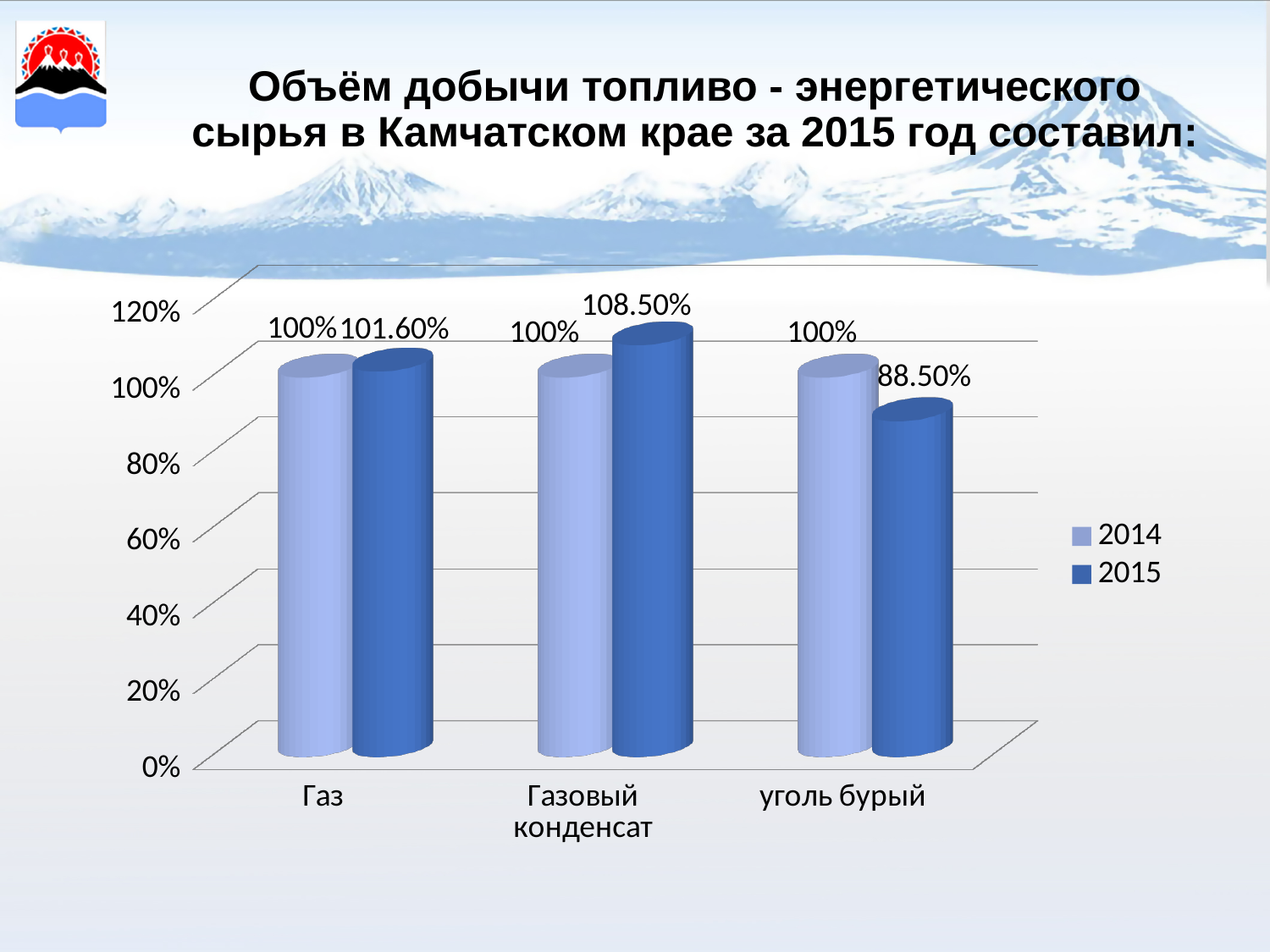
Which category has the highest 2015 value? Газовый конденсат What is the 2015 value for уголь бурый? 88.50% Which is larger for уголь бурый: the 2014 value or the 2015 value? 2014 Is the 2015 value for уголь бурый greater or less than 100%? less How many categories are shown on the x axis? 3 What is the 2015 value for Газ? 101.60% What is the 2014 value for Газ? 100% What is the 2015 value for Газовый конденсат? 108.50% How many series does the legend list? 2 What kind of chart is shown on the slide? bar chart Which category has the lowest 2015 value? уголь бурый What is the difference between the 2015 and 2014 values for Газовый конденсат? 8.50%